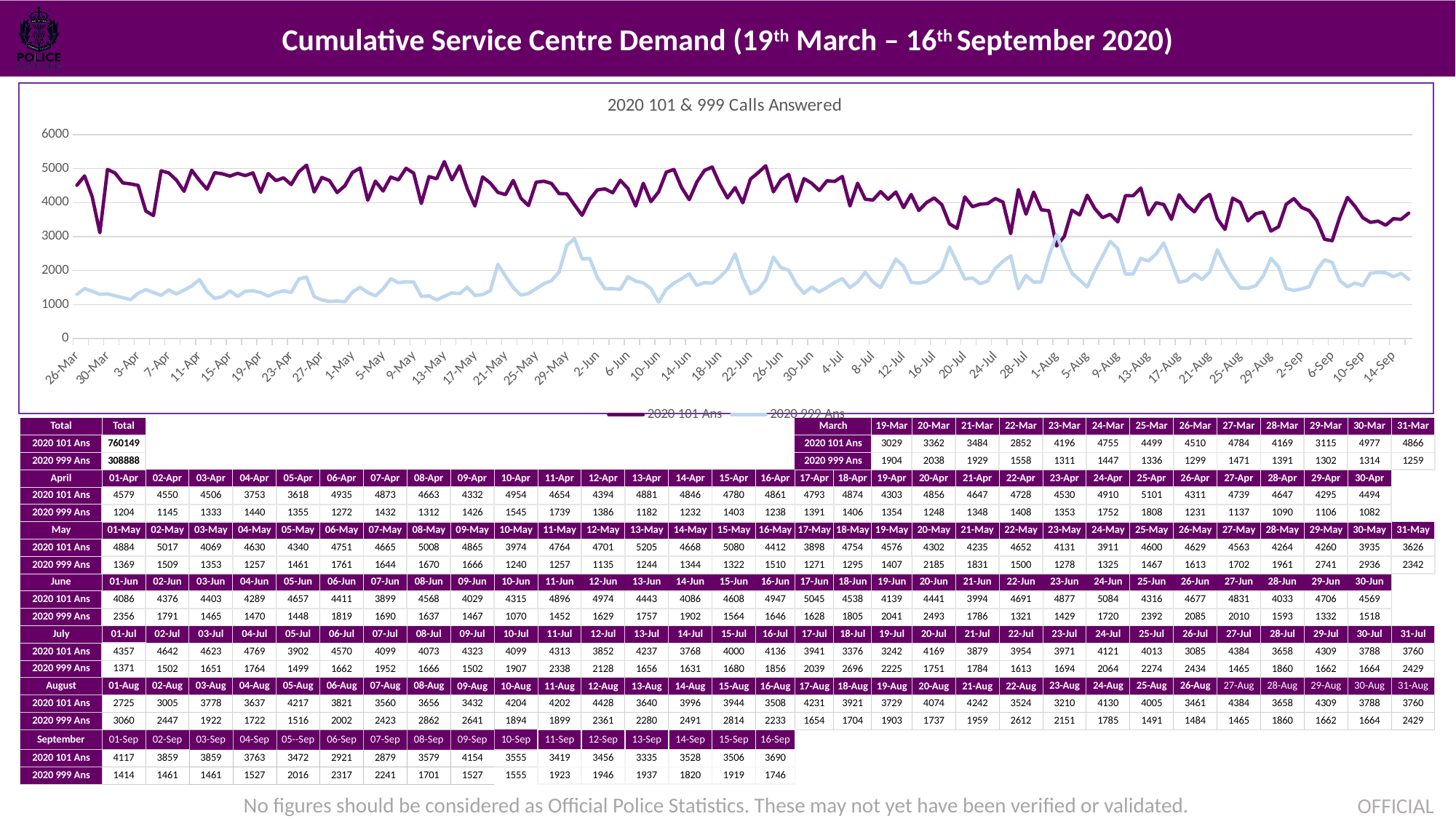
Does the 2020 101 Ans line generally rise or fall from March to September? fall What is the total for 2020 101 Ans? 760149 What is the value of 2020 101 Ans on 19-Mar? 3029 What kind of chart is shown on the slide? line chart How many series does the chart's legend list? 2 What is the difference between 2020 101 Ans and 2020 999 Ans on 19-Mar? 1125 What is the total for 2020 999 Ans? 308888 What is the value of 2020 999 Ans on 19-Mar? 1904 What is the value of 2020 101 Ans on 16-Sep? 3690 Which series is higher on 1-Jun, 2020 101 Ans or 2020 999 Ans? 2020 101 Ans Is the value for 2020 999 Ans on 29-May greater or less than 2000? greater What is the title of the chart? 2020 101 & 999 Calls Answered